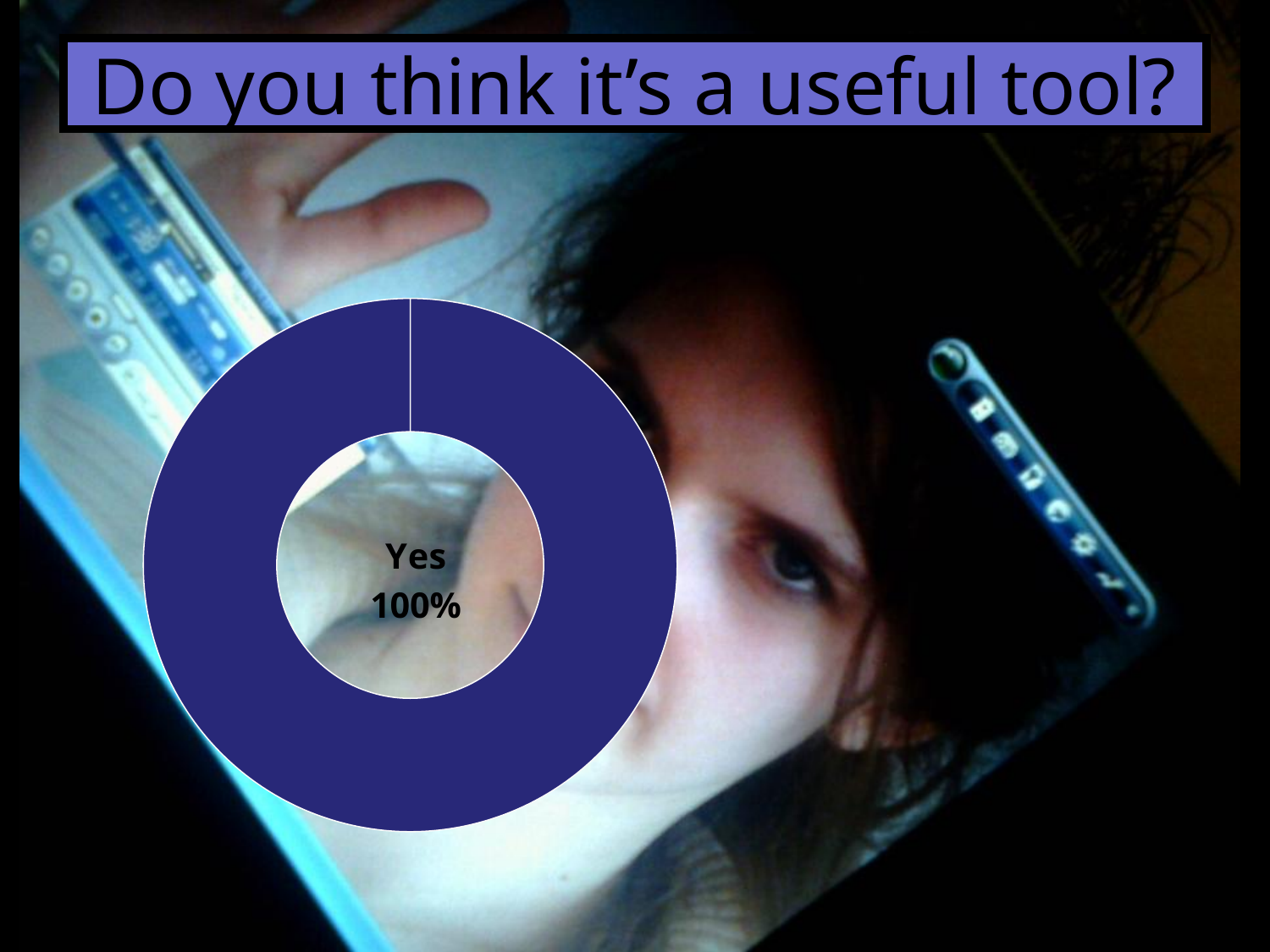
What kind of chart is shown on the slide? Doughnut chart Is the value for "Yes" greater or less than 50%? greater How many slices are shown in the doughnut chart? 1 What percentage is shown for the "Yes" slice? 100% What colour is the "Yes" slice of the doughnut chart? Dark blue What is the title of the slide containing the chart? Do you think it's a useful tool? What share of the doughnut does the "Yes" slice take up? 100% Which category is the only one shown in the chart? Yes